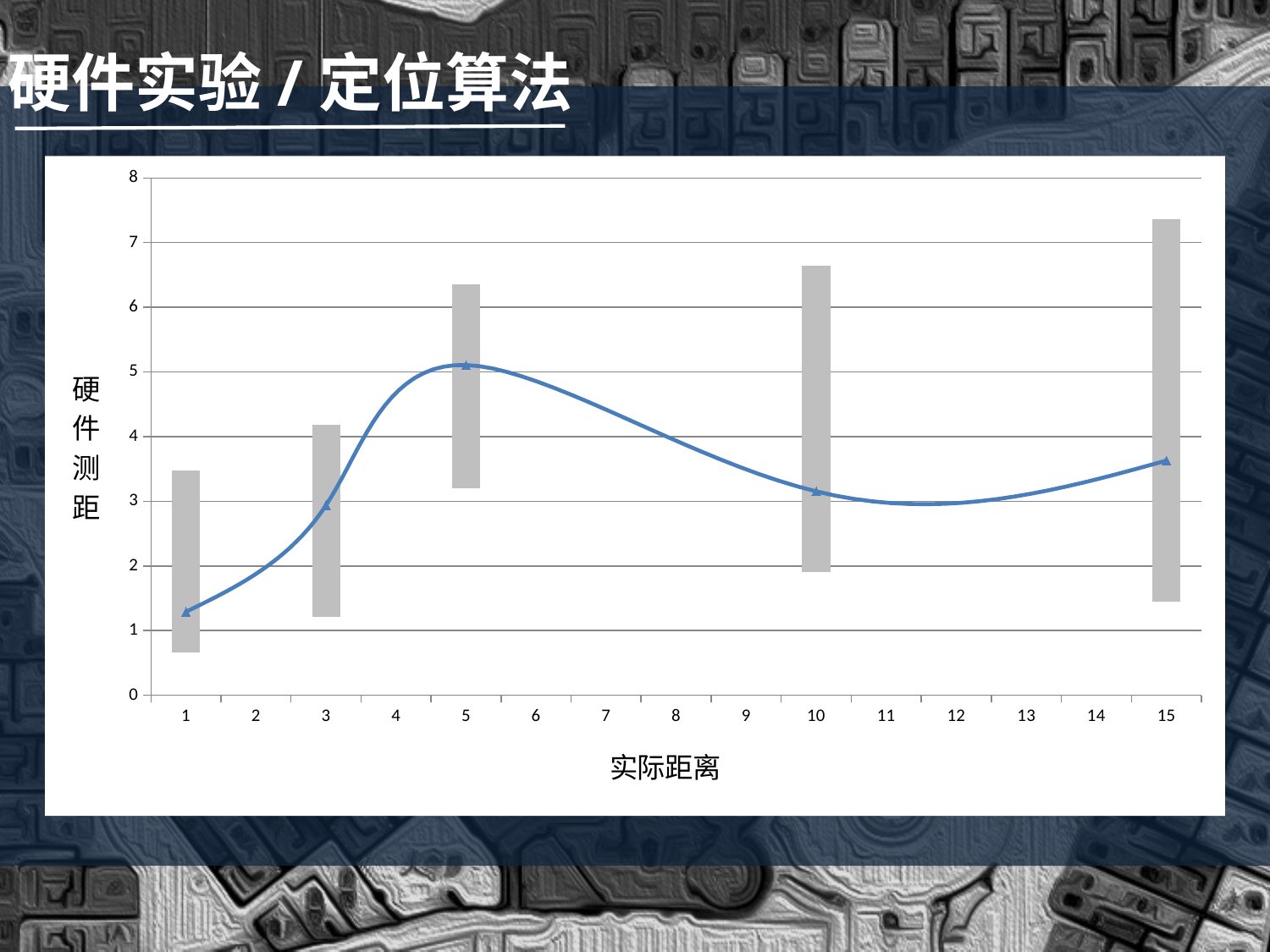
Is the value at 实际距离 5 greater or less than 4? greater Is the value at 实际距离 1 greater or less than 2? less Does the plotted line rise or fall between 实际距离 1 and 实际距离 5? rise Is the value at 实际距离 10 greater or less than 4? less At which 实际距离 value is the plotted 硬件测距 highest? 5 Which has the larger plotted value, 实际距离 3 or 实际距离 5? 5 What is the title of the y axis? 硬件测距 What kind of chart is shown on the slide? a combination chart with floating bars and a line What is the title of the x axis? 实际距离 At which 实际距离 value is the plotted 硬件测距 lowest? 1 How many marked data points does the line have? 5